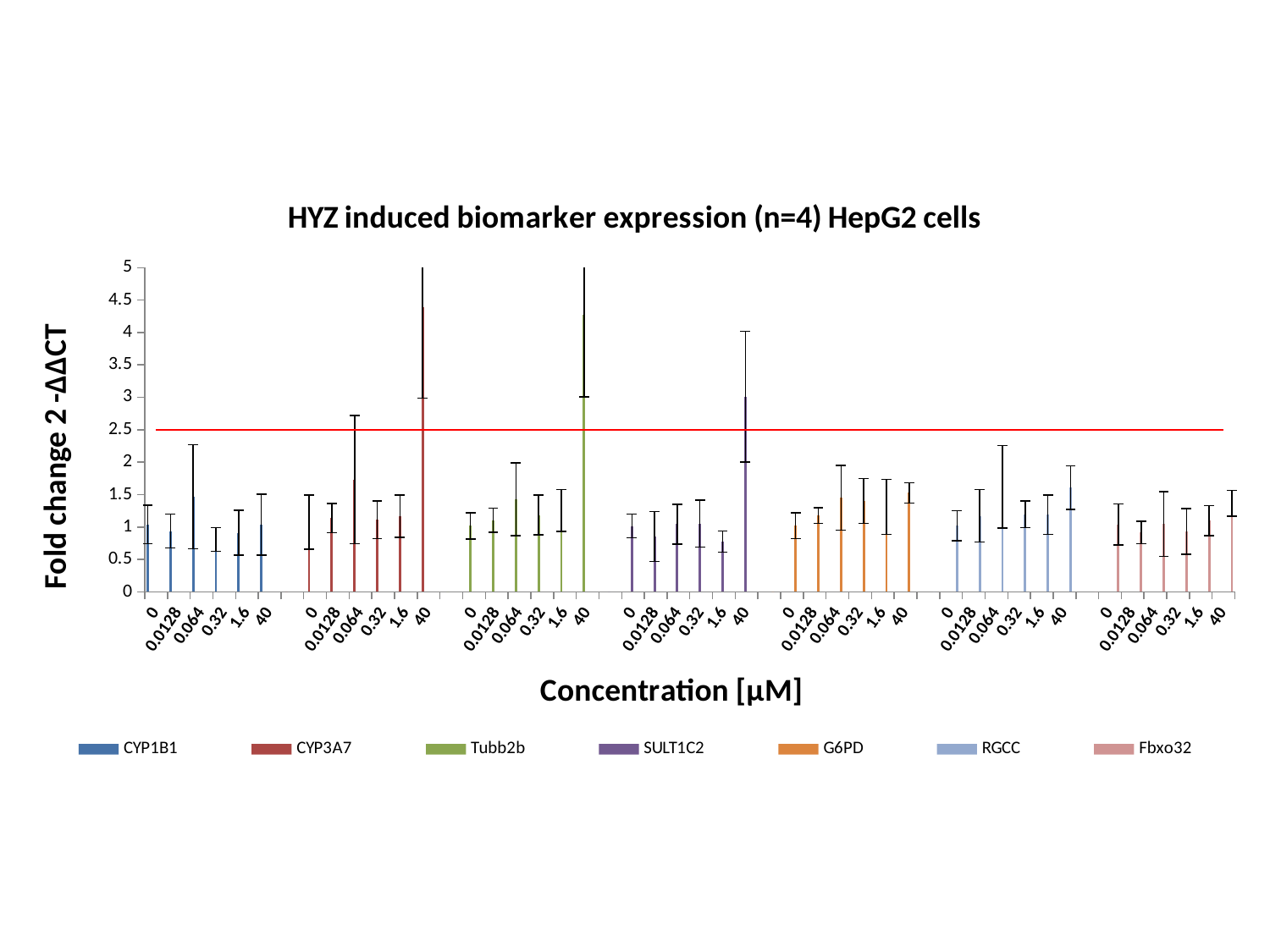
Is the G6PD value at 0.064 µM greater or less than 2? less What kind of chart is shown on the slide? bar chart How many series does the legend list? 7 Is the CYP3A7 value at 40 µM greater or less than 2.5? greater What is the title of the chart? HYZ induced biomarker expression (n=4) HepG2 cells At which concentration is the SULT1C2 fold change highest? 40 At which concentration is the CYP3A7 fold change highest? 40 How many concentration categories are plotted for each series? 6 Is the SULT1C2 value at 40 µM greater or less than 2.5? greater Which is larger at 40 µM: the CYP3A7 value or the CYP1B1 value? CYP3A7 At what y-axis value is the horizontal red line drawn? 2.5 At which concentration is the Tubb2b fold change highest? 40